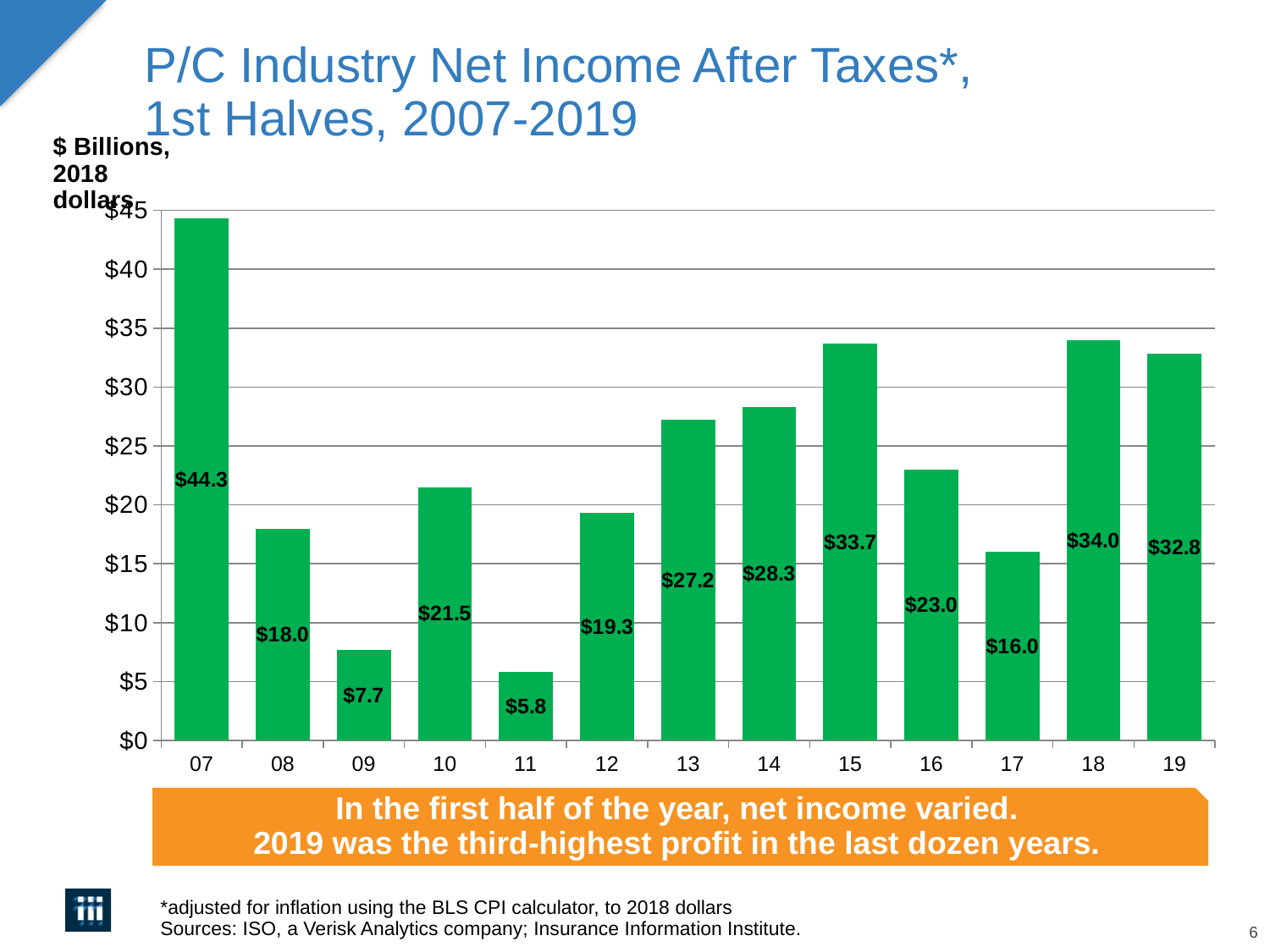
What is the net income value shown for 19? $32.8 What unit is stated for the values in the chart? $ Billions, 2018 dollars What kind of chart is shown on the slide? bar chart What is the difference between the values for 07 and 11? $38.5 Which year has the lowest net income in the chart? 11 What is the difference between the values for 18 and 19? $1.2 Is the value for 14 greater or less than $25? greater Which year has the highest net income in the chart? 07 How many years are shown on the x axis of the chart? 13 What is the net income value shown for 11? $5.8 Which is larger, the value for 15 or the value for 16? 15 What is the net income value shown for 07? $44.3